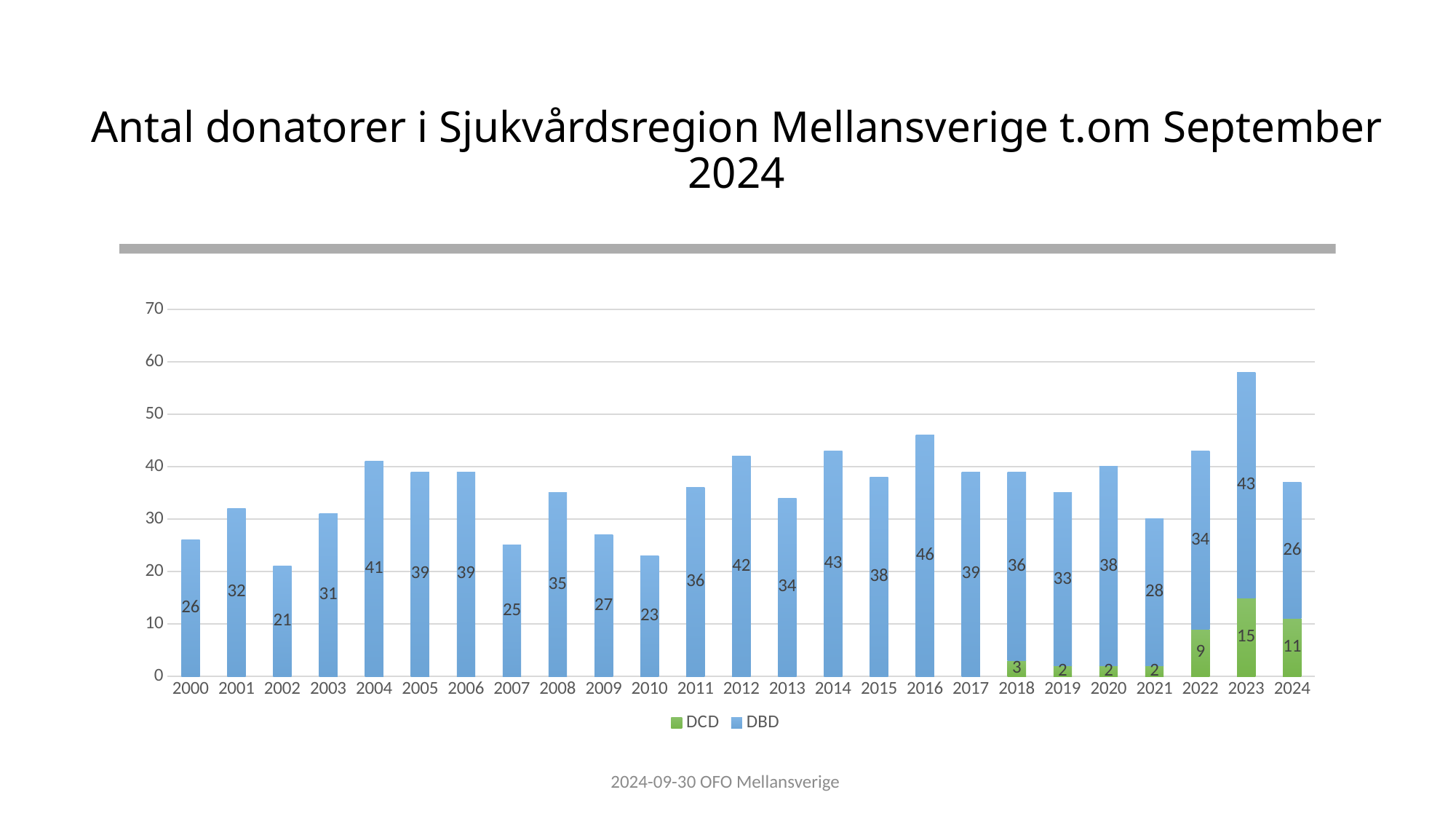
Which year has the lowest DBD value? 2002 Which is larger, the DCD value for 2022 or the DCD value for 2024? 2024 What is the DBD value for 2002? 21 What is the difference between the DBD values for 2004 and 2007? 16 How many years are shown on the x axis? 25 Which year has the highest DBD value? 2016 What is the DCD value for 2023? 15 What is the total of the stacked bar for 2022? 43 What kind of chart is shown on the slide? Stacked bar chart How many series does the legend list? 2 What is the total of the stacked bar for 2023? 58 What is the DBD value for 2016? 46